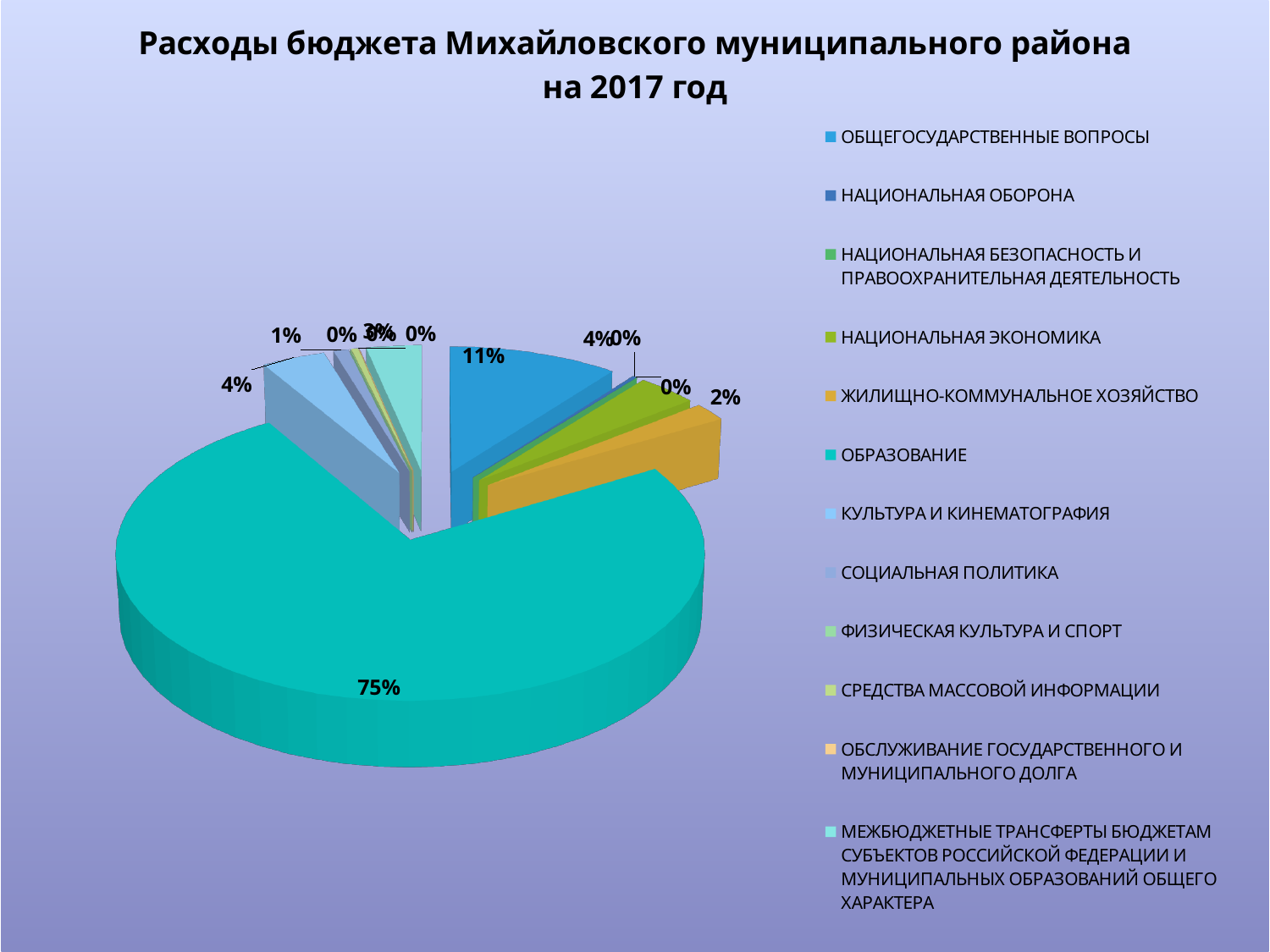
How many categories does the legend list? 12 What share of the pie does НАЦИОНАЛЬНАЯ ЭКОНОМИКА take? 4% What is the difference in percentage points between the share for ОБРАЗОВАНИЕ and the share for ОБЩЕГОСУДАРСТВЕННЫЕ ВОПРОСЫ? 64 Which is larger, the share for ОБРАЗОВАНИЕ or the share for ОБЩЕГОСУДАРСТВЕННЫЕ ВОПРОСЫ? ОБРАЗОВАНИЕ What is the title of the chart? Расходы бюджета Михайловского муниципального района на 2017 год What kind of chart is shown on the slide? pie chart What share of the pie does ОБЩЕГОСУДАРСТВЕННЫЕ ВОПРОСЫ take? 11% What share of the pie does КУЛЬТУРА И КИНЕМАТОГРАФИЯ take? 4% What colour is the slice for ОБРАЗОВАНИЕ? teal Which category has the largest share of the pie? ОБРАЗОВАНИЕ